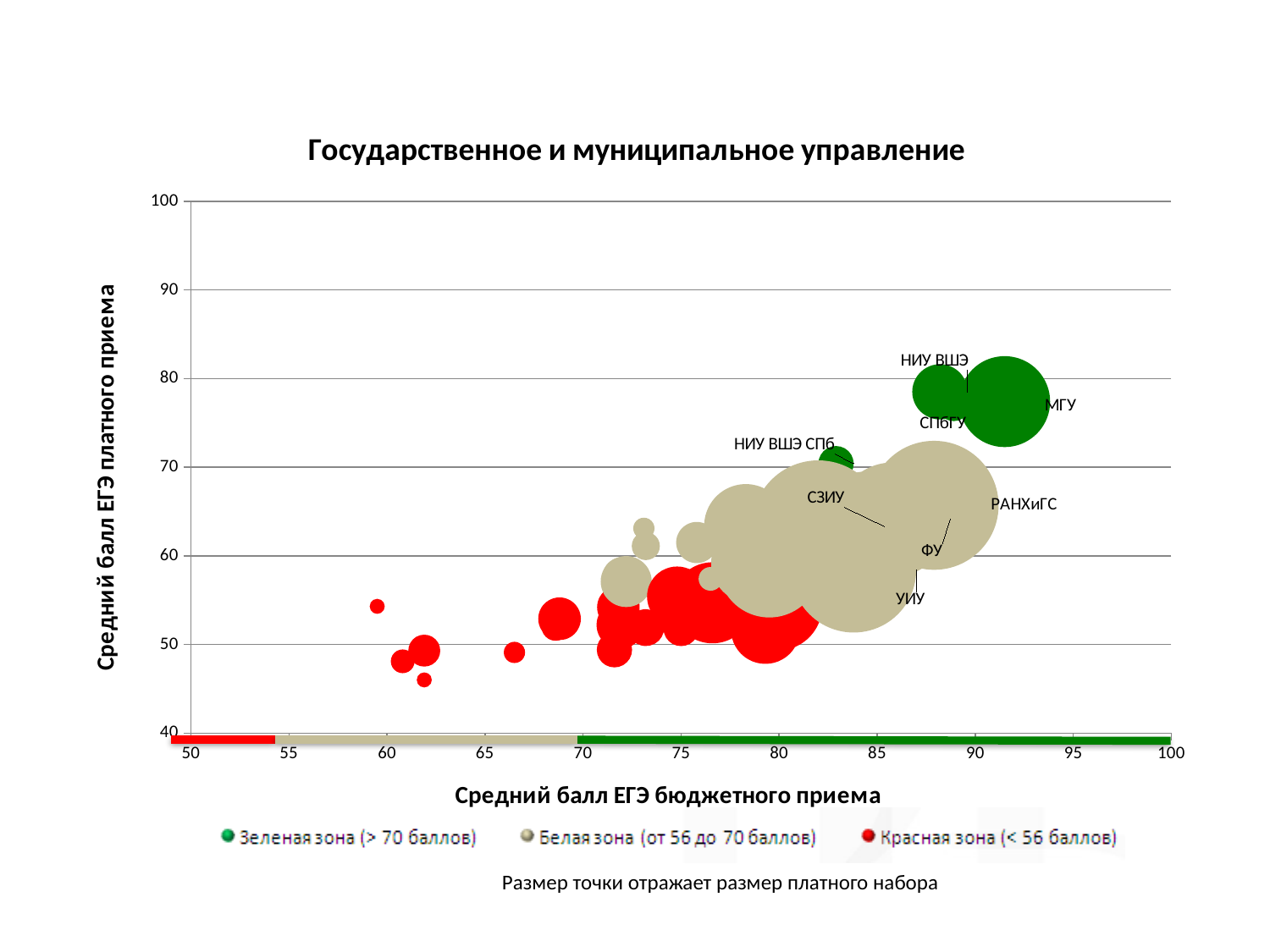
What is the title of the chart? Государственное и муниципальное управление How many series does the legend list? 3 What does the size of a bubble represent, according to the note under the chart? Размер платного набора Which labeled university has the largest bubble on the chart? РАНХиГС What kind of chart is shown on the slide? Bubble chart Is the value on the y axis (Средний балл ЕГЭ платного приема) for МГУ greater or less than 70? greater Which has the higher value on the x axis, МГУ or НИУ ВШЭ? МГУ Is the value on the x axis for РАНХиГС greater or less than 80? greater Is the value on the x axis (Средний балл ЕГЭ бюджетного приема) for МГУ greater or less than 90? greater Which zone (series) does the МГУ bubble belong to? Зеленая зона (> 70 баллов)